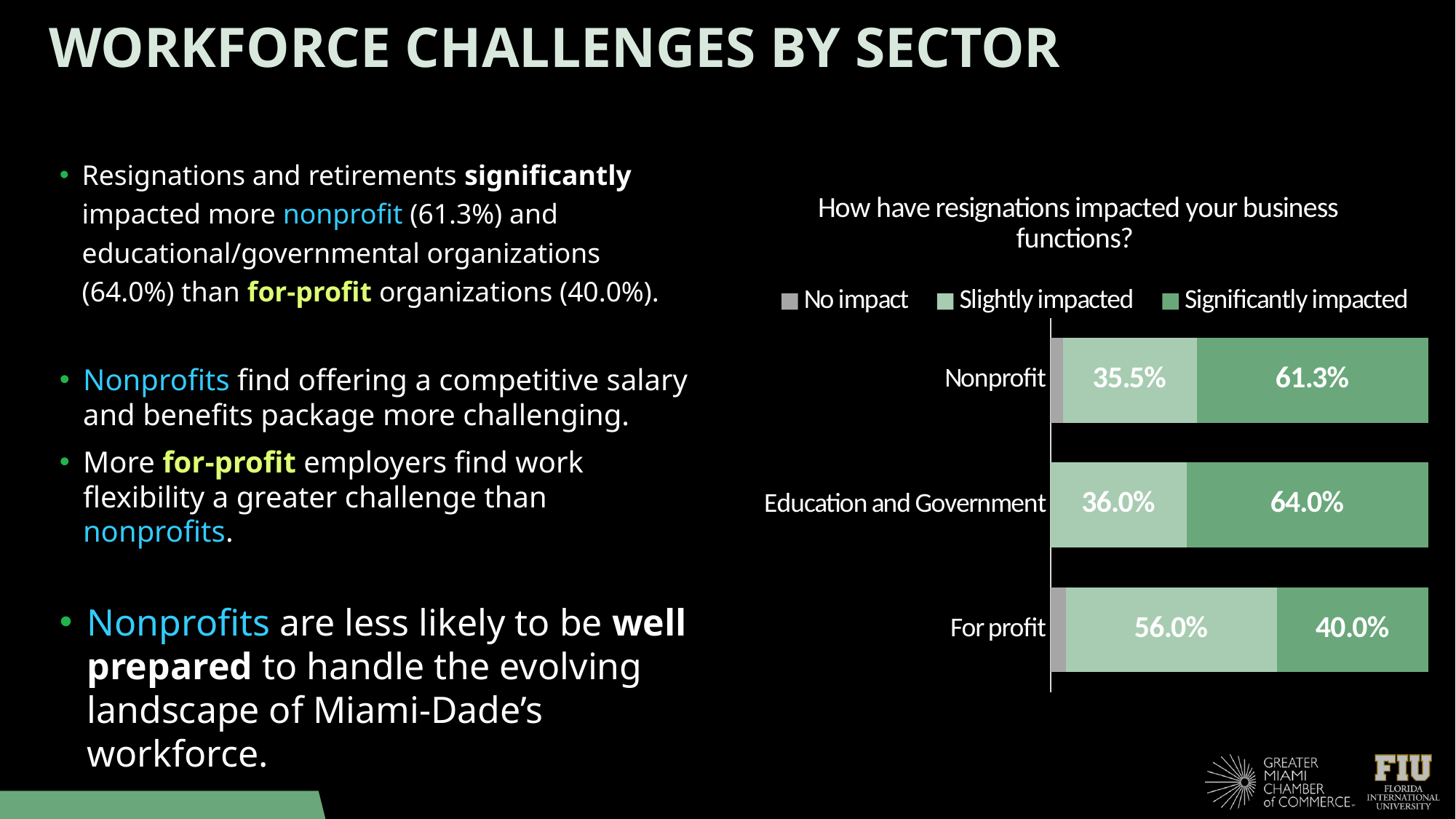
What is the 'Slightly impacted' value for Nonprofit? 35.5% What is the title of the chart? How have resignations impacted your business functions? Which category has the highest 'Significantly impacted' value? Education and Government What is the 'Significantly impacted' value for Nonprofit? 61.3% What is the 'Significantly impacted' value for Education and Government? 64.0% What is the 'Slightly impacted' value for For profit? 56.0% What is the difference between the 'Significantly impacted' values for Education and Government and For profit? 24.0% How many series does the chart legend list? 3 What kind of chart is shown on the slide? Stacked bar chart Which is larger: the 'Slightly impacted' value for For profit or the 'Slightly impacted' value for Education and Government? For profit How many categories are shown on the chart? 3 Which category has the lowest 'Significantly impacted' value? For profit